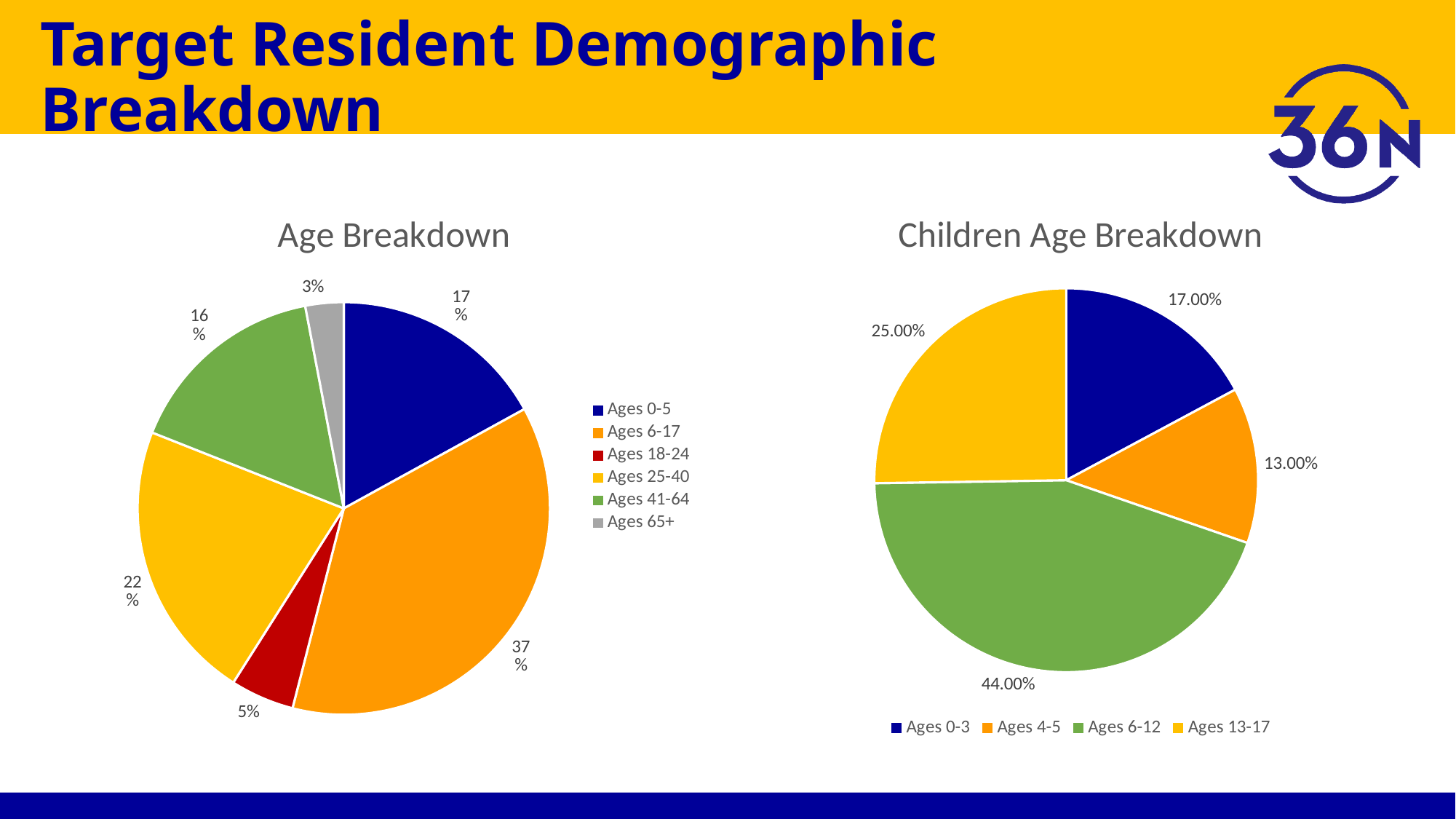
In the Children Age Breakdown chart, how many age groups does the legend list? 4 In the Age Breakdown chart, how many age groups are shown? 6 In the Age Breakdown chart, what is the difference between the shares for Ages 25-40 and Ages 41-64? 6% In the Children Age Breakdown chart, what share is Ages 4-5? 13.00% What type of chart is the Children Age Breakdown chart? Pie chart In the Age Breakdown chart, which age group has the largest share? Ages 6-17 In the Age Breakdown chart, what share is Ages 65+? 3% In the Children Age Breakdown chart, what share is Ages 6-12? 44.00% In the Age Breakdown chart, which age group has the smallest share? Ages 65+ In the Children Age Breakdown chart, which age group has the smallest share? Ages 4-5 In the Age Breakdown chart, what share is Ages 6-17? 37% In the Children Age Breakdown chart, which is larger, Ages 0-3 or Ages 13-17? Ages 13-17